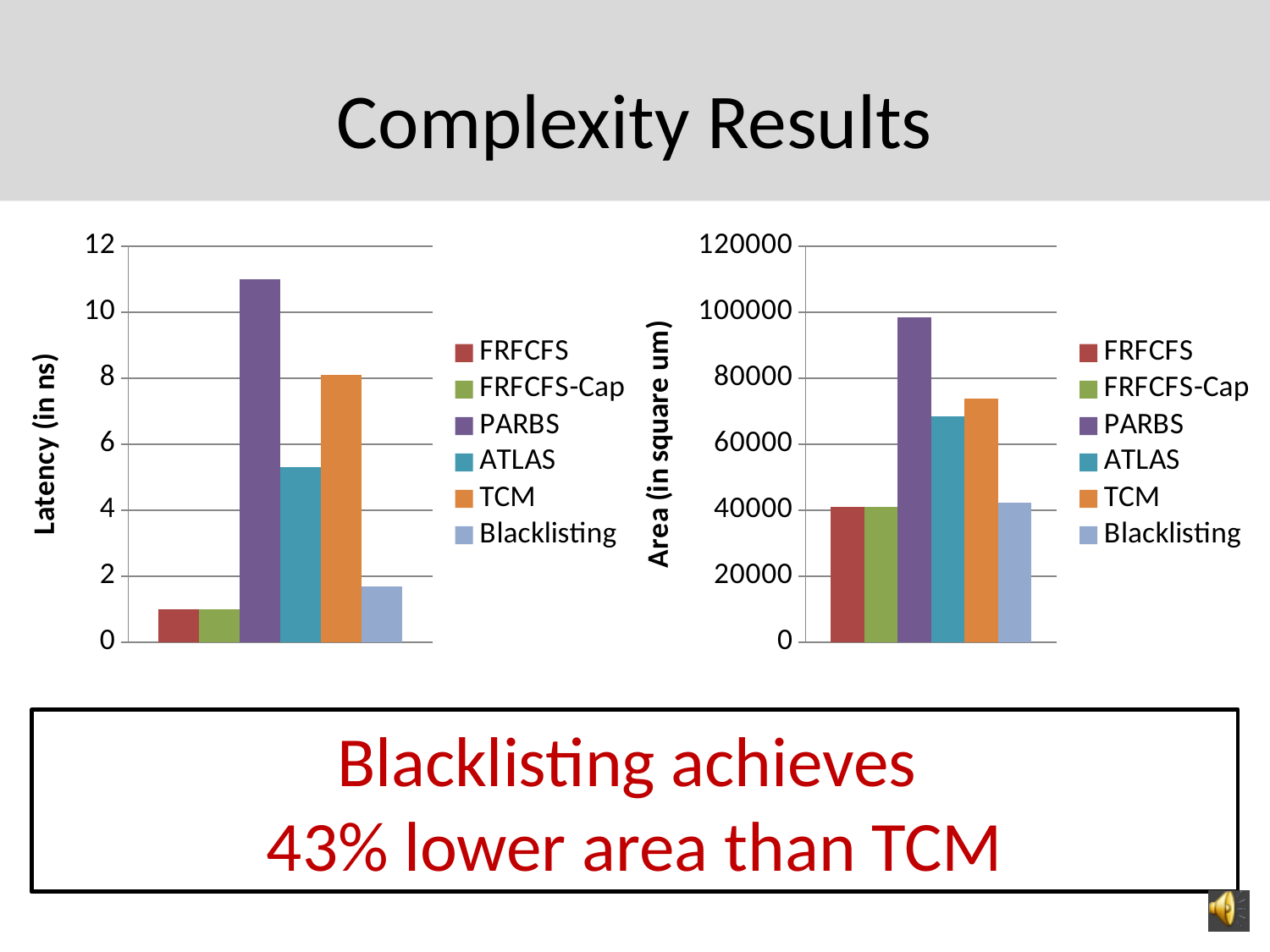
In the right chart (Area in square um), is the value for PARBS greater or less than 80000? greater In the right chart (Area in square um), is the value for Blacklisting greater or less than 60000? less What kind of chart is the left chart (Latency in ns)? bar chart In the left chart (Latency in ns), which has the higher latency, Blacklisting or ATLAS? ATLAS In the left chart (Latency in ns), which series has the highest latency? PARBS In the right chart (Area in square um), which series has the largest area? PARBS What is the y-axis label of the right chart? Area (in square um) How many series does the legend of the right chart (Area in square um) list? 6 In the right chart (Area in square um), which has the larger area, TCM or ATLAS? TCM In the left chart (Latency in ns), which has the higher latency, TCM or ATLAS? TCM In the left chart (Latency in ns), is the value for ATLAS greater or less than 6? less